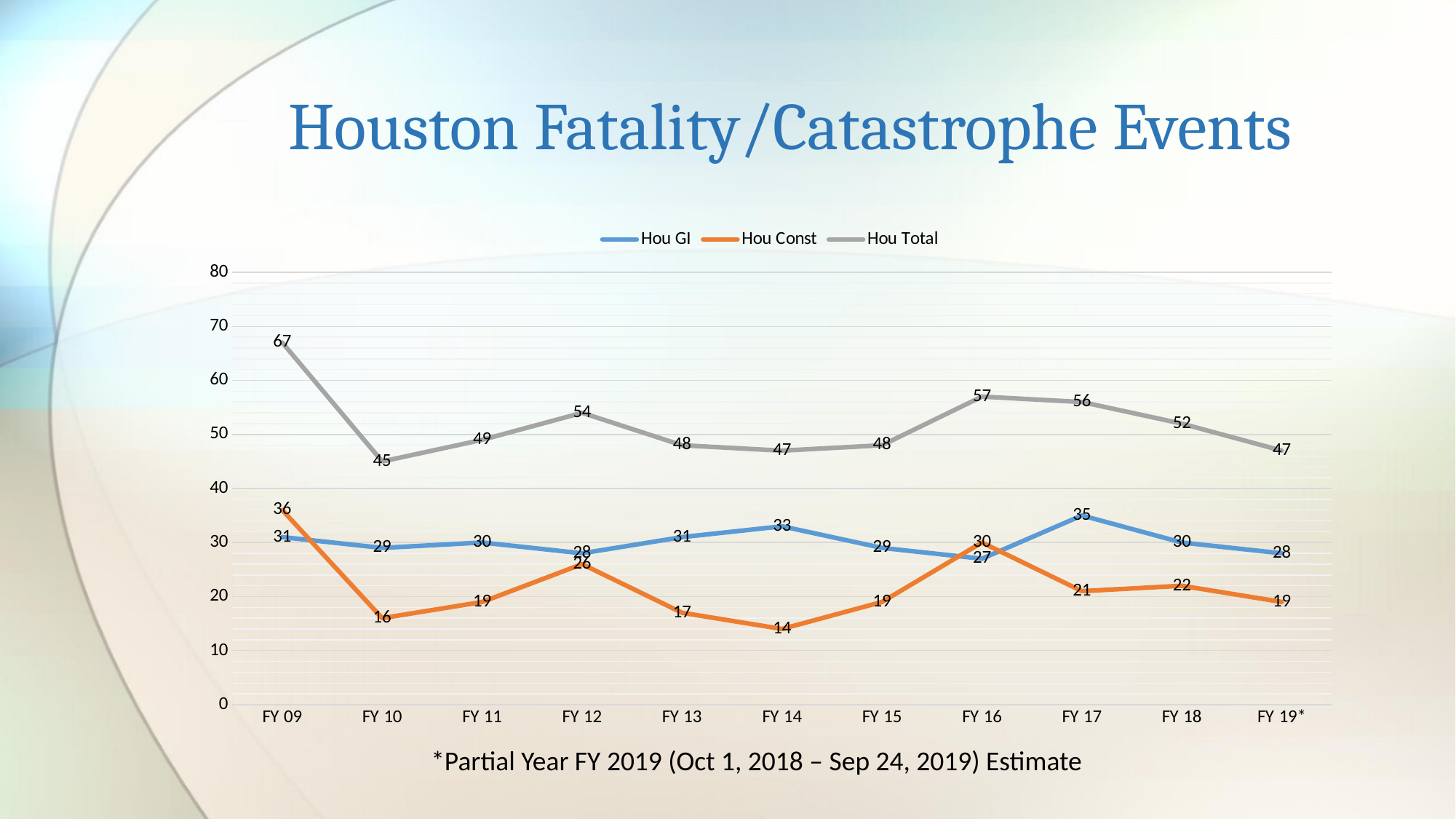
What is the Hou Total value for FY 09? 67 In which fiscal year is the Hou Total value highest? FY 09 What is the Hou Const value for FY 14? 14 How many series does the legend list? 3 What is the difference between the Hou Total values for FY 09 and FY 10? 22 How many fiscal years are plotted along the x axis? 11 Which is larger in FY 16, the Hou GI value or the Hou Const value? Hou Const What is the Hou GI value for FY 17? 35 Does the Hou Total value fall or rise from FY 17 to FY 19*? fall In which fiscal year is the Hou Const value lowest? FY 14 What type of chart is shown on the slide? line chart What is the title of the chart? Houston Fatality/Catastrophe Events